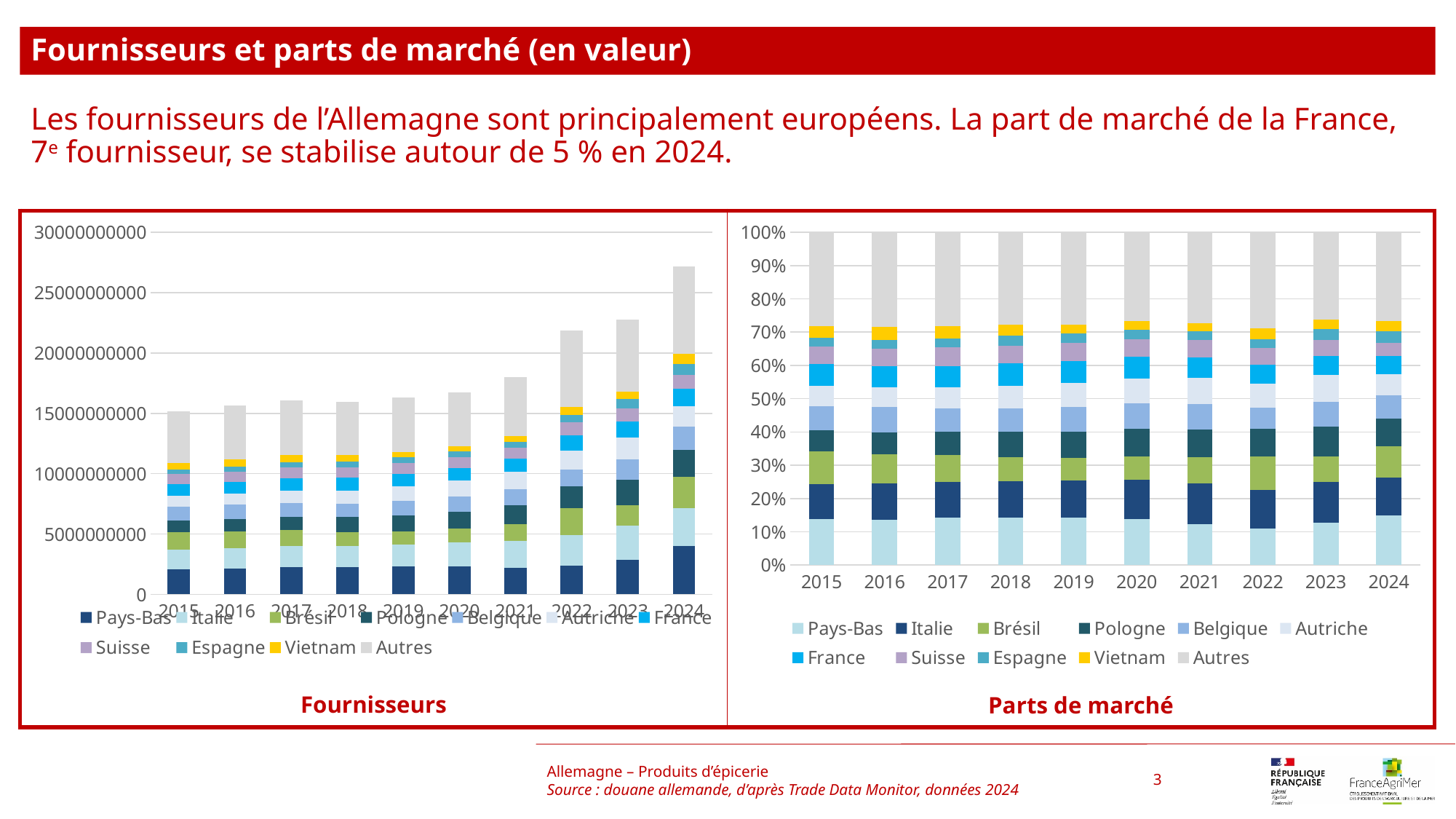
In the 'Fournisseurs' chart, which year has the highest total bar? 2024 In the 'Parts de marché' chart, is the share for Pays-Bas in 2024 greater or less than 10%? greater In the 'Fournisseurs' chart, which total bar is larger, 2023 or 2024? 2024 What kind of chart is the 'Fournisseurs' chart on the left? Stacked bar chart In the 'Fournisseurs' chart, how many years are shown on the x axis? 10 In the 'Fournisseurs' chart, is the total bar for 2022 greater or less than 20000000000? greater In the 'Fournisseurs' chart, is the total bar for 2021 greater or less than 20000000000? less What kind of chart is the 'Parts de marché' chart on the right? 100% stacked bar chart In the 'Parts de marché' chart, which series is listed first in the legend? Pays-Bas In the 'Parts de marché' chart, how many series does the legend list? 11 In the 'Fournisseurs' chart, do the total bars generally rise or fall from 2015 to 2024? Rise